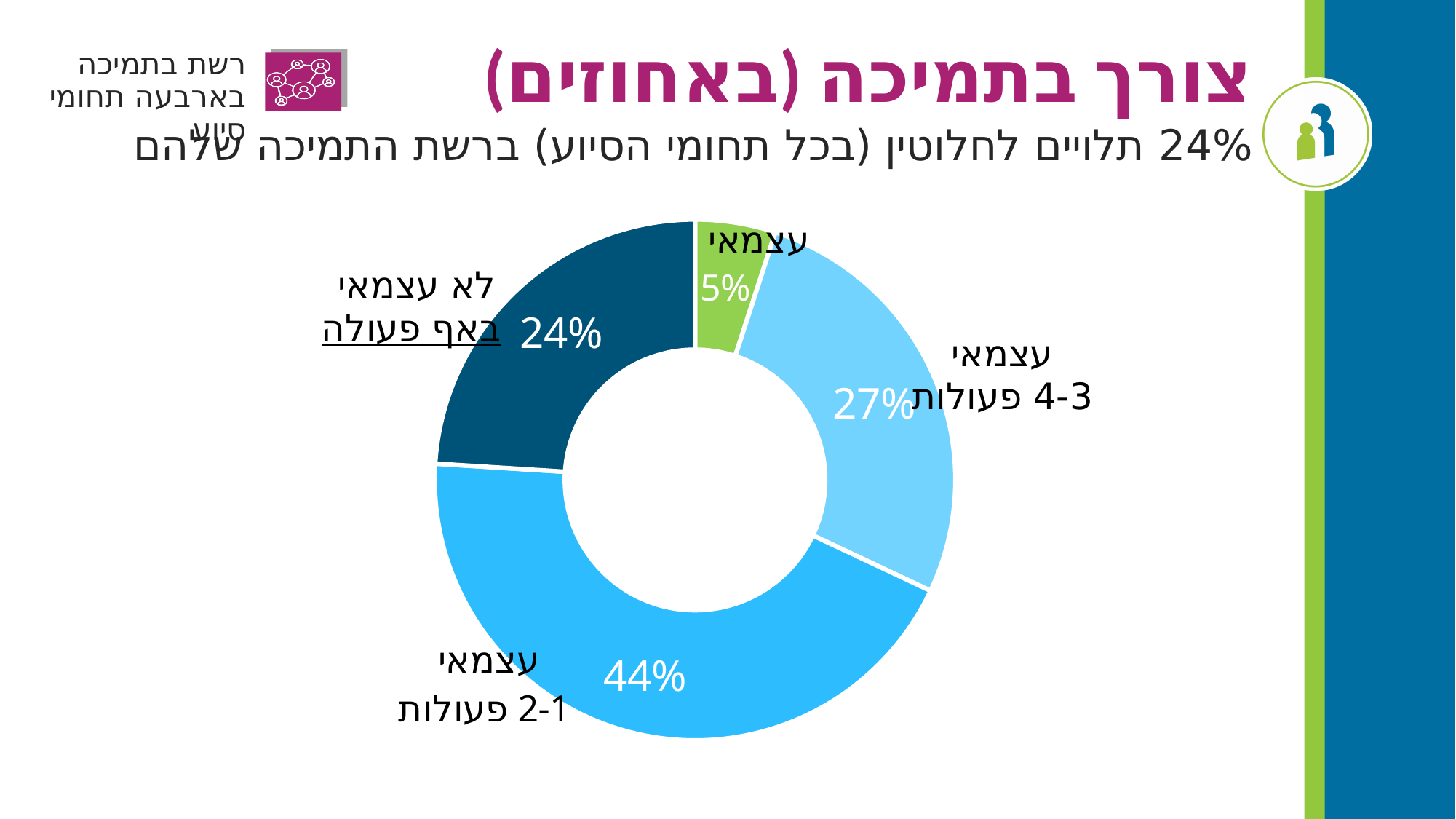
What is the title of the slide containing the chart? צורך בתמיכה (באחוזים) What is the value for the slice labelled עצמאי 3-4 פעולות? 27% What colour is the slice labelled עצמאי? Green What is the value for the slice labelled עצמאי 1-2 פעולות? 44% What kind of chart is shown on the slide? Donut (pie) chart Which is larger: the share for עצמאי 3-4 פעולות or the share for לא עצמאי באף פעולה? עצמאי 3-4 פעולות Which slice has the smallest share? עצמאי How many slices does the chart have? 4 What is the difference between the עצמאי 1-2 פעולות slice and the עצמאי 3-4 פעולות slice? 17% Which slice has the largest share? עצמאי 1-2 פעולות What is the value for the slice labelled לא עצמאי באף פעולה? 24% What is the value for the slice labelled עצמאי? 5%